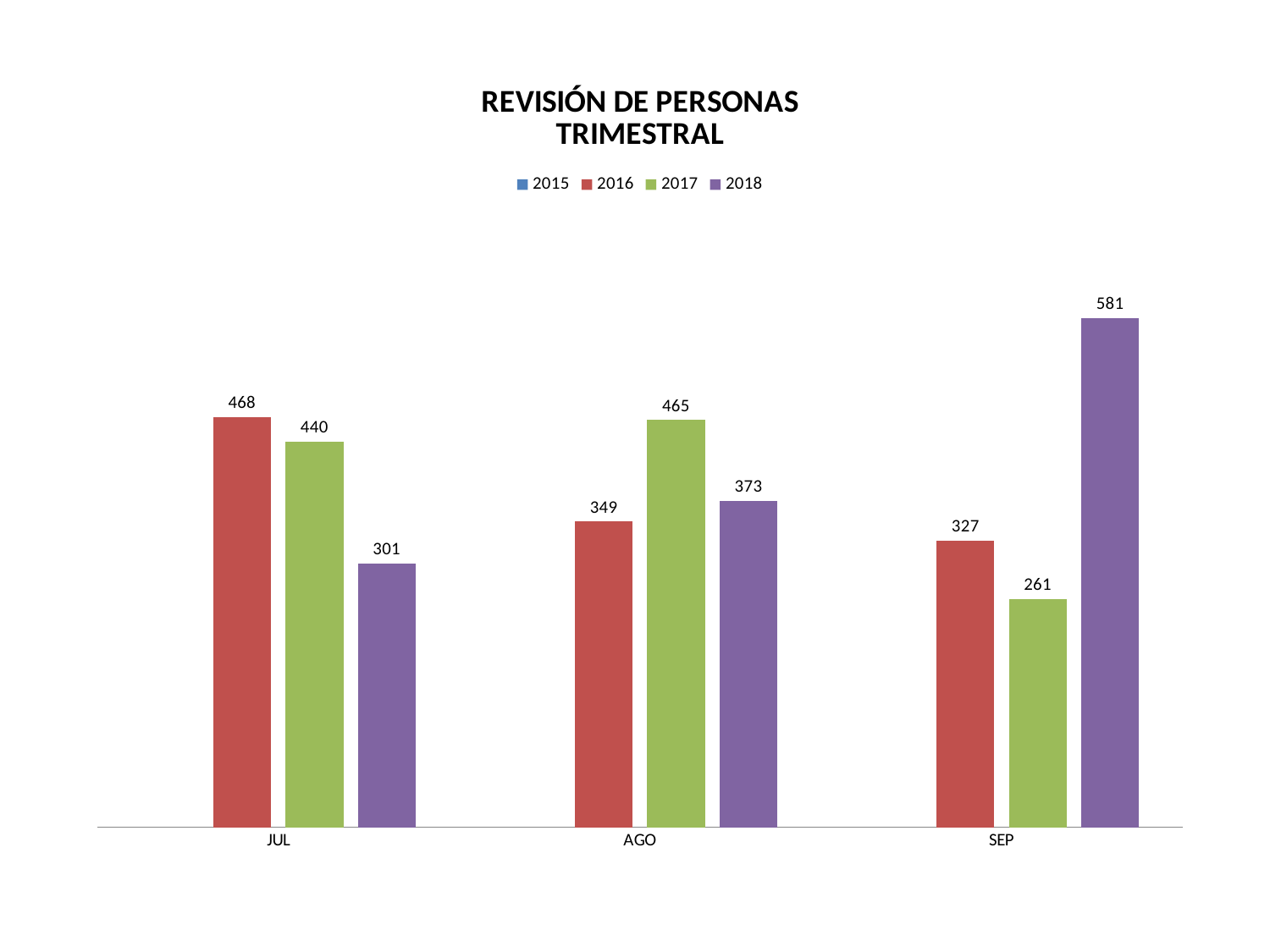
What is the value for 2018 in SEP? 581 Which month has the highest value for 2018? SEP What is the difference between the 2016 and 2018 values in AGO? 24 How many months are shown on the x axis? 3 Which is larger in SEP, the value for 2016 or the value for 2017? 2016 Which month has the lowest value for 2017? SEP What kind of chart is shown on the slide? Bar chart What is the value for 2016 in JUL? 468 How many series does the legend list? 4 What is the value for 2018 in JUL? 301 What is the value for 2017 in AGO? 465